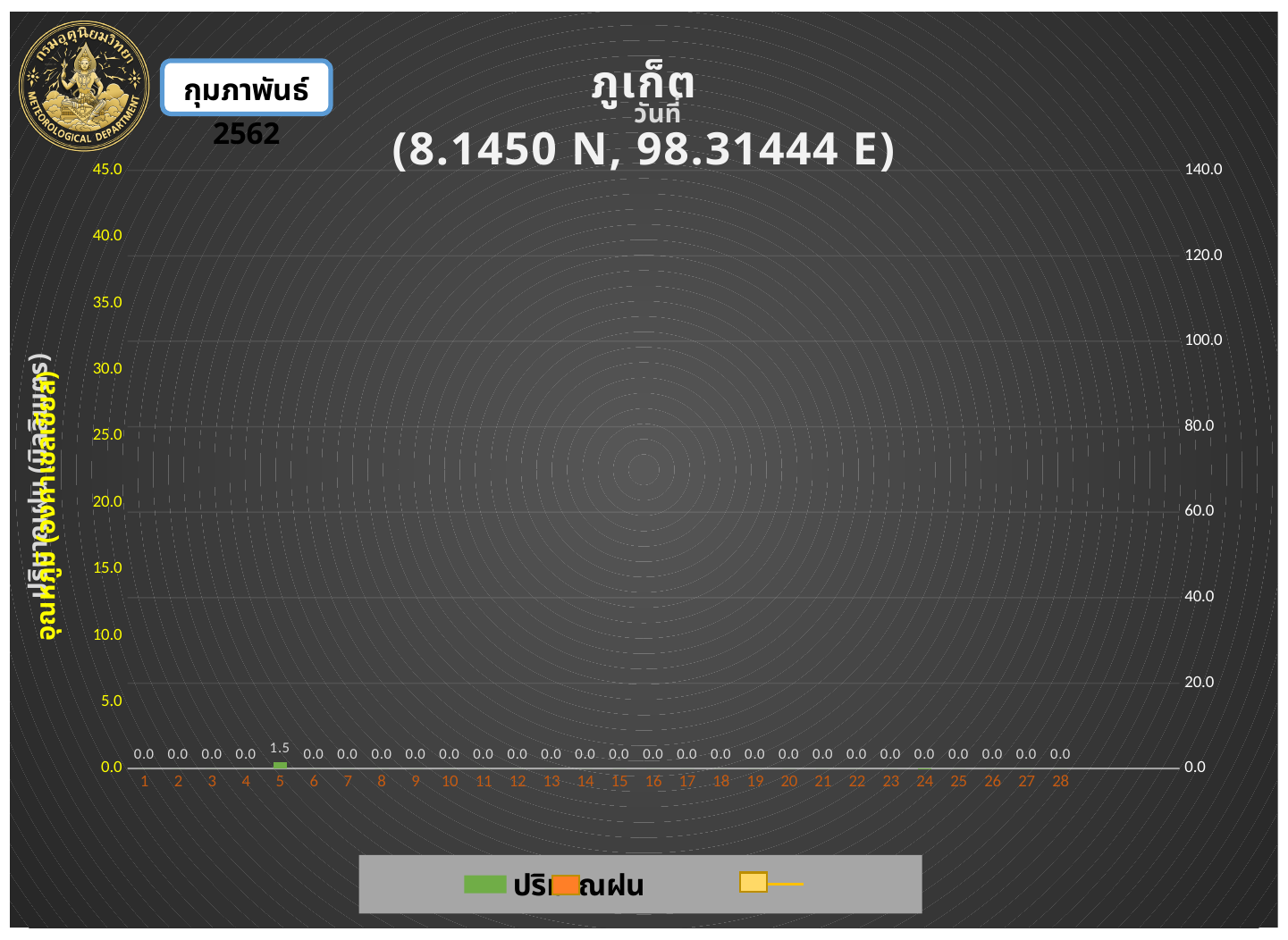
What kind of chart is this? bar chart What is the value shown for day 28? 0.0 What is the highest tick value on the right vertical axis? 140.0 Which is larger, the value for day 5 or the value for day 20? day 5 Which day has the highest value on the chart? 5 What is the highest tick value on the left vertical axis? 45.0 How many days are shown on the x axis? 28 What is the difference between the value for day 5 and the value for day 6? 1.5 What is the rainfall value shown for day 5? 1.5 Is the value for day 5 greater or less than 5.0? less What is the value shown for day 10? 0.0